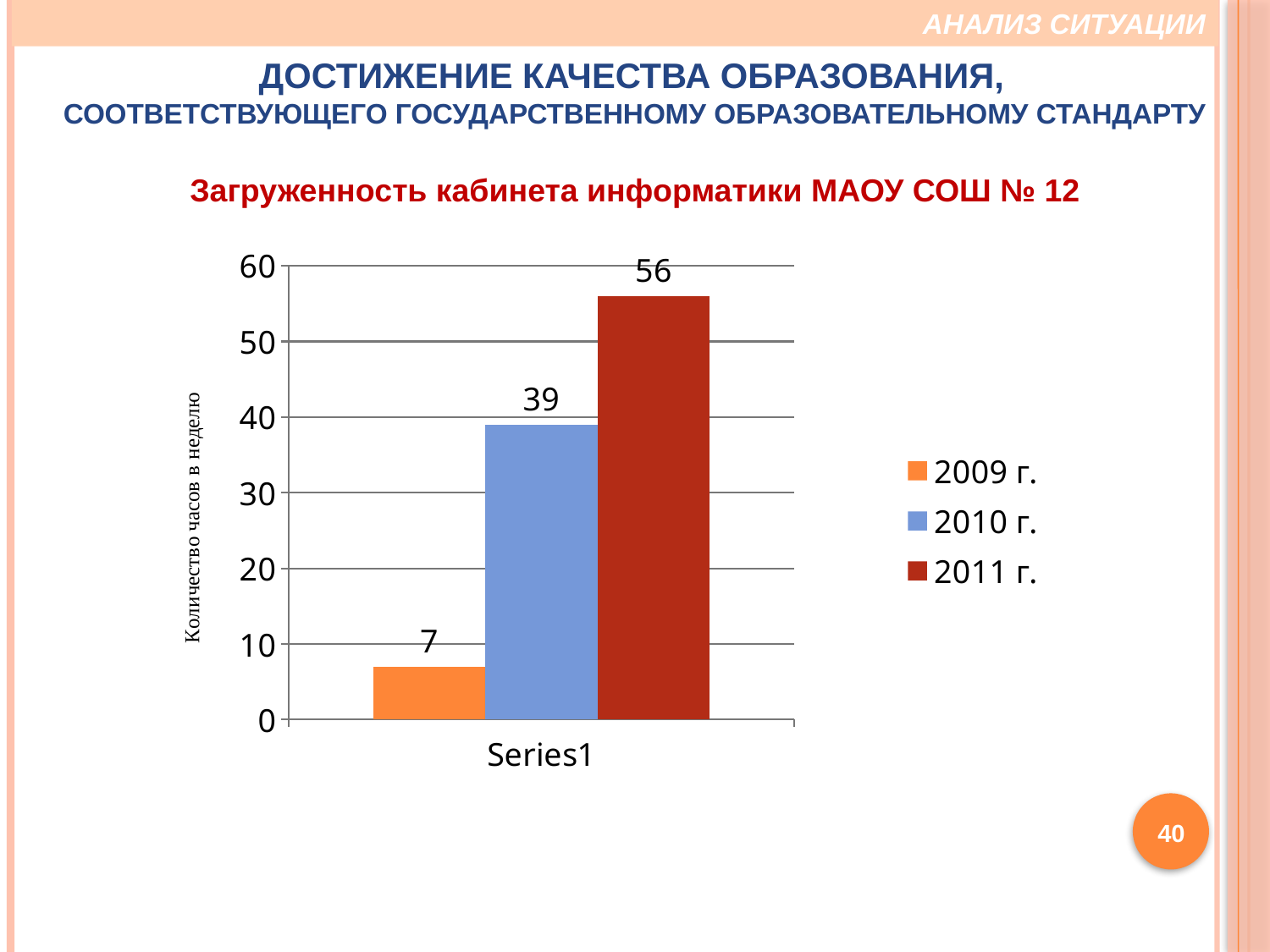
Which year has the highest value? 2011 г. What is the difference between the values for 2011 г. and 2010 г.? 17 Which is larger, the value for 2010 г. or the value for 2009 г.? 2010 г. Which year has the lowest value? 2009 г. What kind of chart is shown on the slide? bar chart What is the difference between the values for 2010 г. and 2009 г.? 32 Is the value for 2011 г. greater or less than 50? greater What is the value for 2011 г.? 56 How many series does the legend list? 3 What is the value for 2009 г.? 7 What is the value for 2010 г.? 39 What is the label on the vertical axis of the chart? Количество часов в неделю